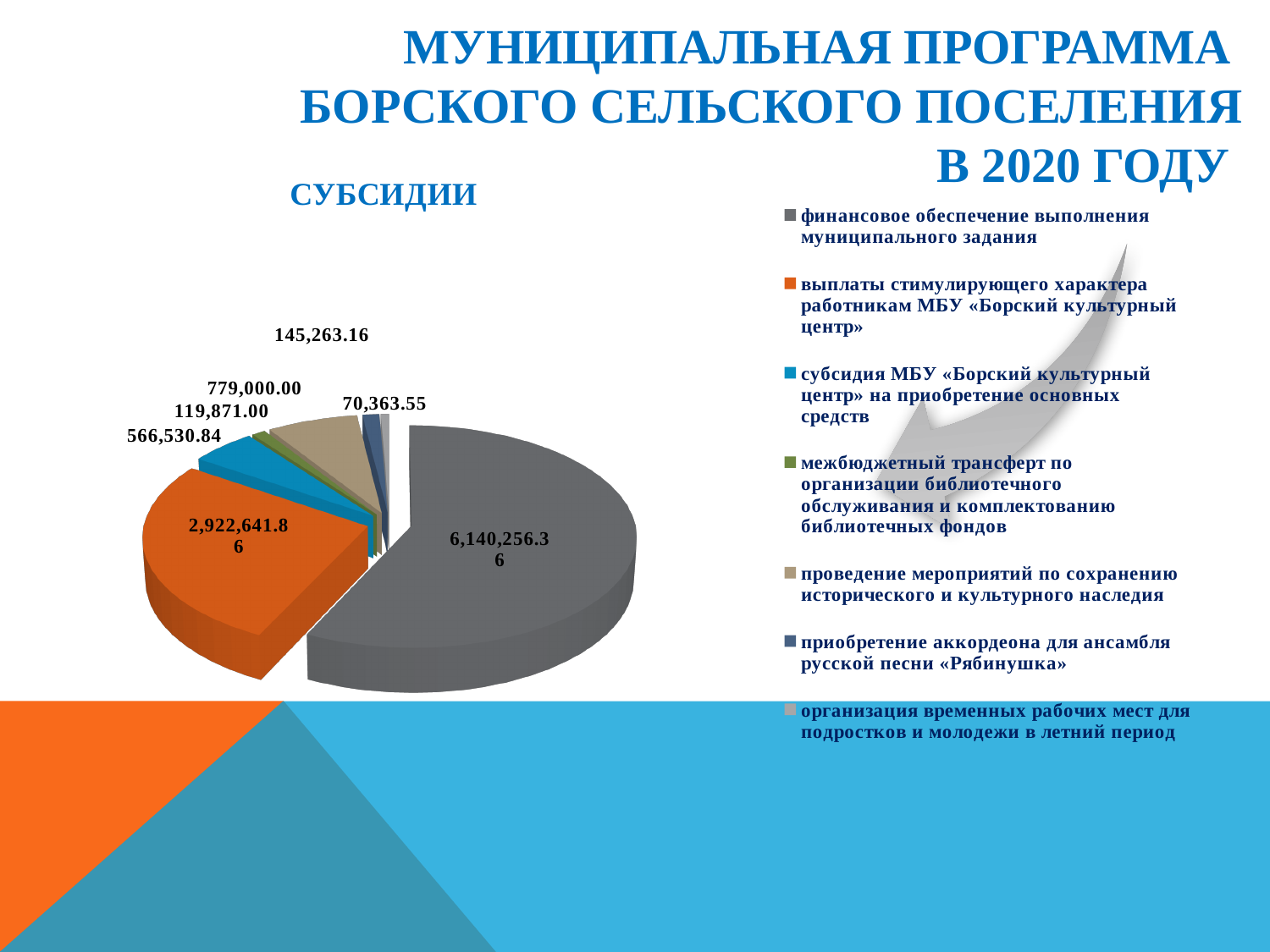
What is the title of the chart? СУБСИДИИ How many slices does the pie chart have? 7 What is the value for «финансовое обеспечение выполнения муниципального задания»? 6,140,256.36 Which category has the largest slice of the pie? финансовое обеспечение выполнения муниципального задания What kind of chart is shown on the slide? pie chart What is the value for «выплаты стимулирующего характера работникам МБУ «Борский культурный центр»»? 2,922,641.86 What is the value for «проведение мероприятий по сохранению исторического и культурного наследия»? 779,000.00 What is the smallest value labelled on the pie chart? 70,363.55 What is the difference between the two largest values, 6,140,256.36 and 2,922,641.86? 3,217,614.50 What is the value for «субсидия МБУ «Борский культурный центр» на приобретение основных средств»? 566,530.84 How many entries does the chart legend list? 7 Which is larger: the slice for «финансовое обеспечение выполнения муниципального задания» or the slice for «выплаты стимулирующего характера работникам МБУ «Борский культурный центр»»? финансовое обеспечение выполнения муниципального задания